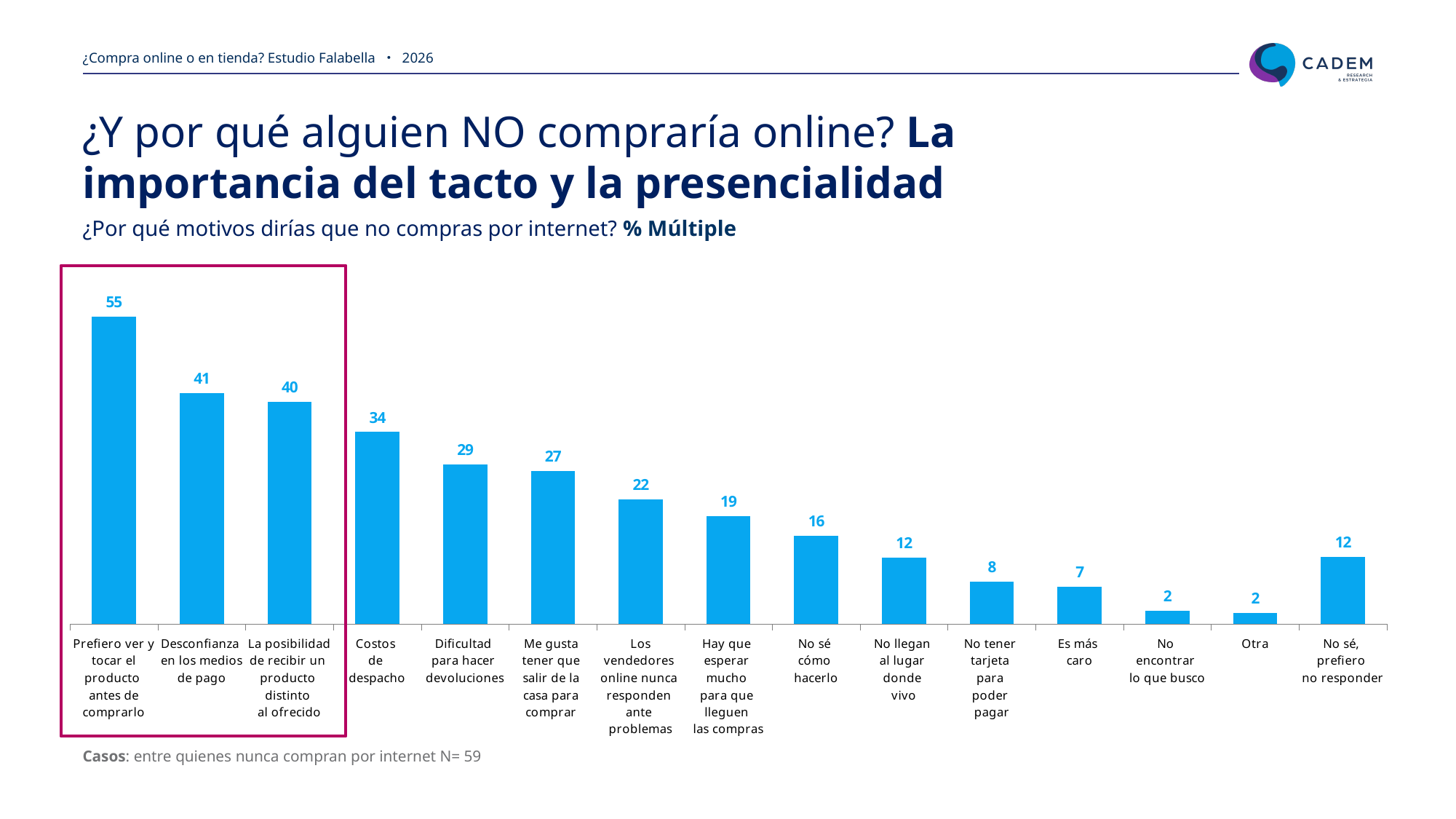
Which reason has the highest value in the chart? Prefiero ver y tocar el producto antes de comprarlo What value is shown for "No sé cómo hacerlo"? 16 What value is shown for "Es más caro"? 7 Which is larger: the value for "Me gusta tener que salir de la casa para comprar" or the value for "Los vendedores online nunca responden ante problemas"? Me gusta tener que salir de la casa para comprar What is the difference between the values for "Dificultad para hacer devoluciones" and "Hay que esperar mucho para que lleguen las compras"? 10 What value is shown for "Costos de despacho"? 34 How many categories (reasons) are shown in the chart? 15 What is the difference between the values for "Prefiero ver y tocar el producto antes de comprarlo" and "La posibilidad de recibir un producto distinto al ofrecido"? 15 How many bars are enclosed by the highlighted box on the left of the chart? 3 What kind of chart is shown on the slide? Bar chart What value is shown for "No sé, prefiero no responder"? 12 What value is shown for "Desconfianza en los medios de pago"? 41